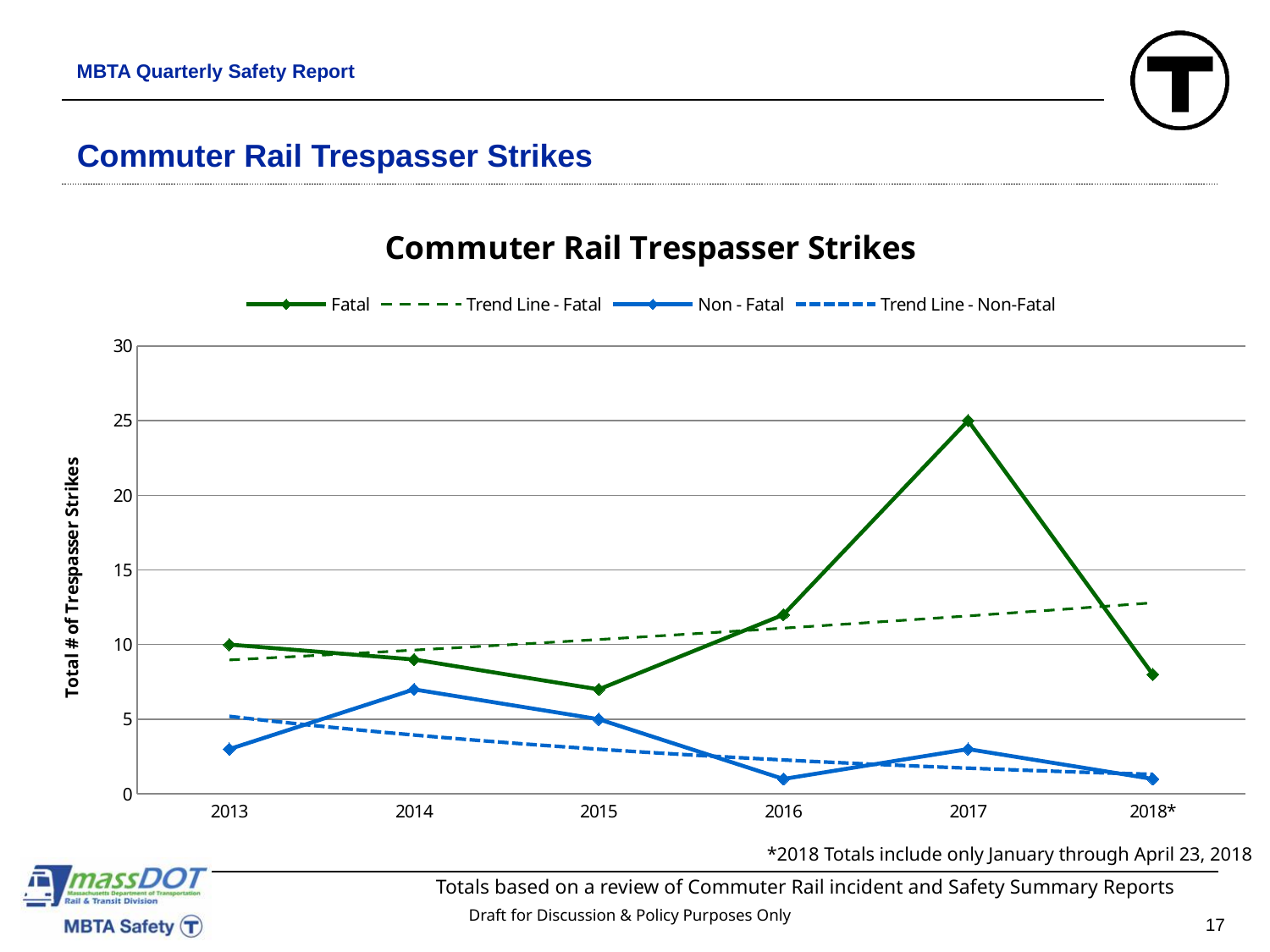
Is the Non - Fatal value for 2016 greater or less than 5? less What is the value of the Fatal series in 2013? 10 In which year is the Non - Fatal series highest? 2014 How many series does the legend list? 4 Does the Trend Line - Non-Fatal rise or fall from 2013 to 2018*? fall What is the value of the Fatal series in 2017? 25 How many years are shown along the x axis? 6 What is the value of the Non - Fatal series in 2015? 5 In which year is the Fatal series highest? 2017 Is the Fatal value for 2016 greater or less than 10? greater What type of chart is shown on the slide? line chart What is the difference between the Fatal value in 2017 and the Fatal value in 2013? 15